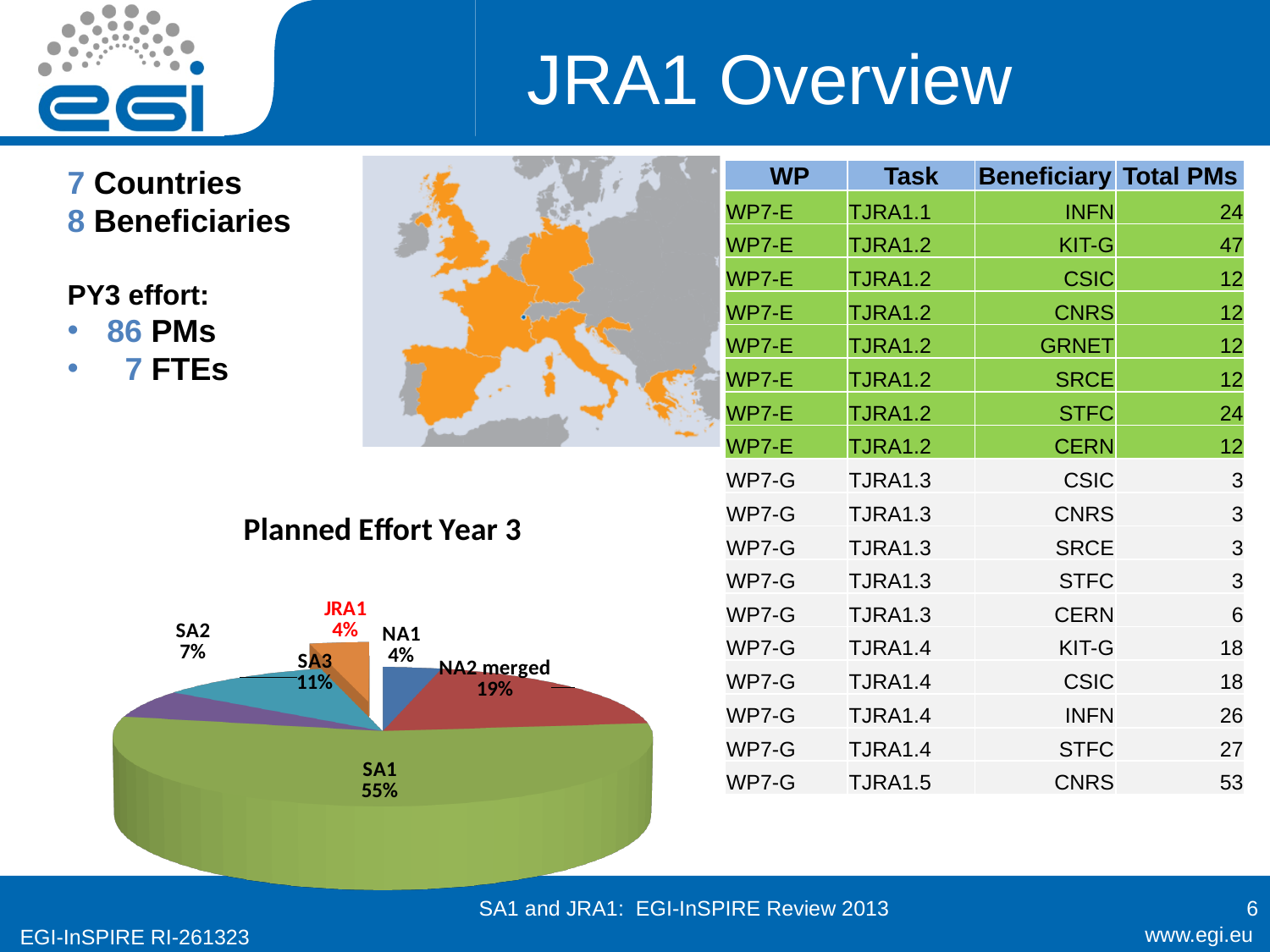
In the Planned Effort Year 3 pie chart, what share does JRA1 have? 4% In the Planned Effort Year 3 pie chart, what colour is the SA1 slice? green In the Planned Effort Year 3 pie chart, which is larger, SA3 or SA2? SA3 In the Planned Effort Year 3 pie chart, which slice is the largest? SA1 In the Planned Effort Year 3 pie chart, what share does SA3 have? 11% In the Planned Effort Year 3 pie chart, what share does SA1 have? 55% What is the title of the pie chart on the slide? Planned Effort Year 3 In the Planned Effort Year 3 pie chart, what share does SA2 have? 7% In the Planned Effort Year 3 pie chart, what share does NA2 merged have? 19% In the Planned Effort Year 3 pie chart, how many slices are there? 6 What kind of chart is shown under the heading "Planned Effort Year 3"? pie chart In the Planned Effort Year 3 pie chart, what is the difference in percentage points between SA1 and NA2 merged? 36